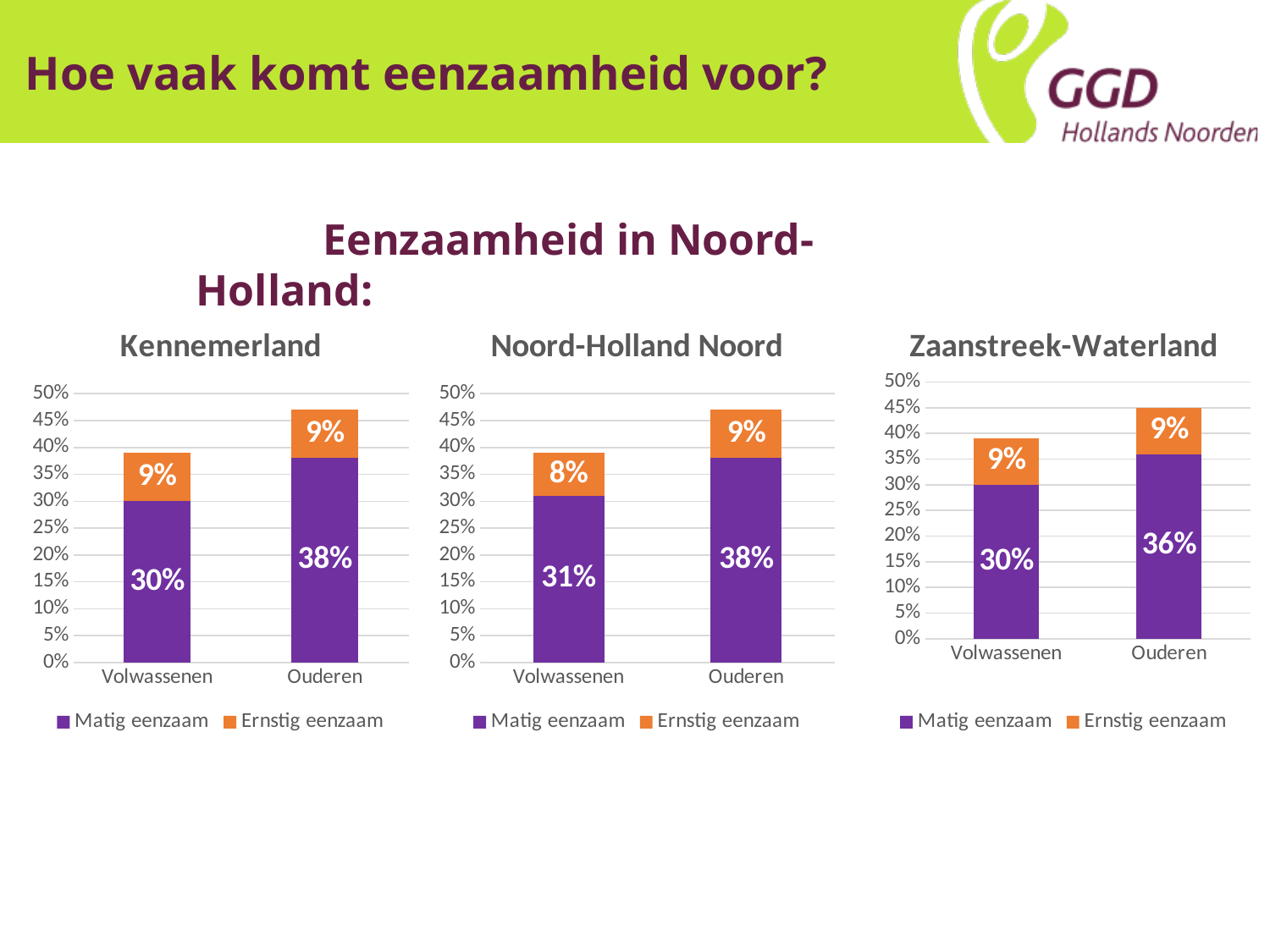
In the Kennemerland chart, what is the value of Ernstig eenzaam for Ouderen? 9% In the Kennemerland chart, what is the value of Matig eenzaam for Volwassenen? 30% In the Zaanstreek-Waterland chart, what is the value of Matig eenzaam for Ouderen? 36% How many categories are shown on the x axis of the Zaanstreek-Waterland chart? 2 In the Noord-Holland Noord chart, what is the value of Matig eenzaam for Ouderen? 38% In the Zaanstreek-Waterland chart, what is the total of the stacked bar for Volwassenen? 39% How many series does the legend of the Kennemerland chart list? 2 In the Noord-Holland Noord chart, what is the value of Ernstig eenzaam for Volwassenen? 8% In the Kennemerland chart, what is the total of the stacked bar for Ouderen? 47% In the Zaanstreek-Waterland chart, which category has the higher Matig eenzaam value, Volwassenen or Ouderen? Ouderen In the Noord-Holland Noord chart, what is the difference between Matig eenzaam for Ouderen and Matig eenzaam for Volwassenen? 7% What kind of chart is the Noord-Holland Noord chart? Stacked bar chart